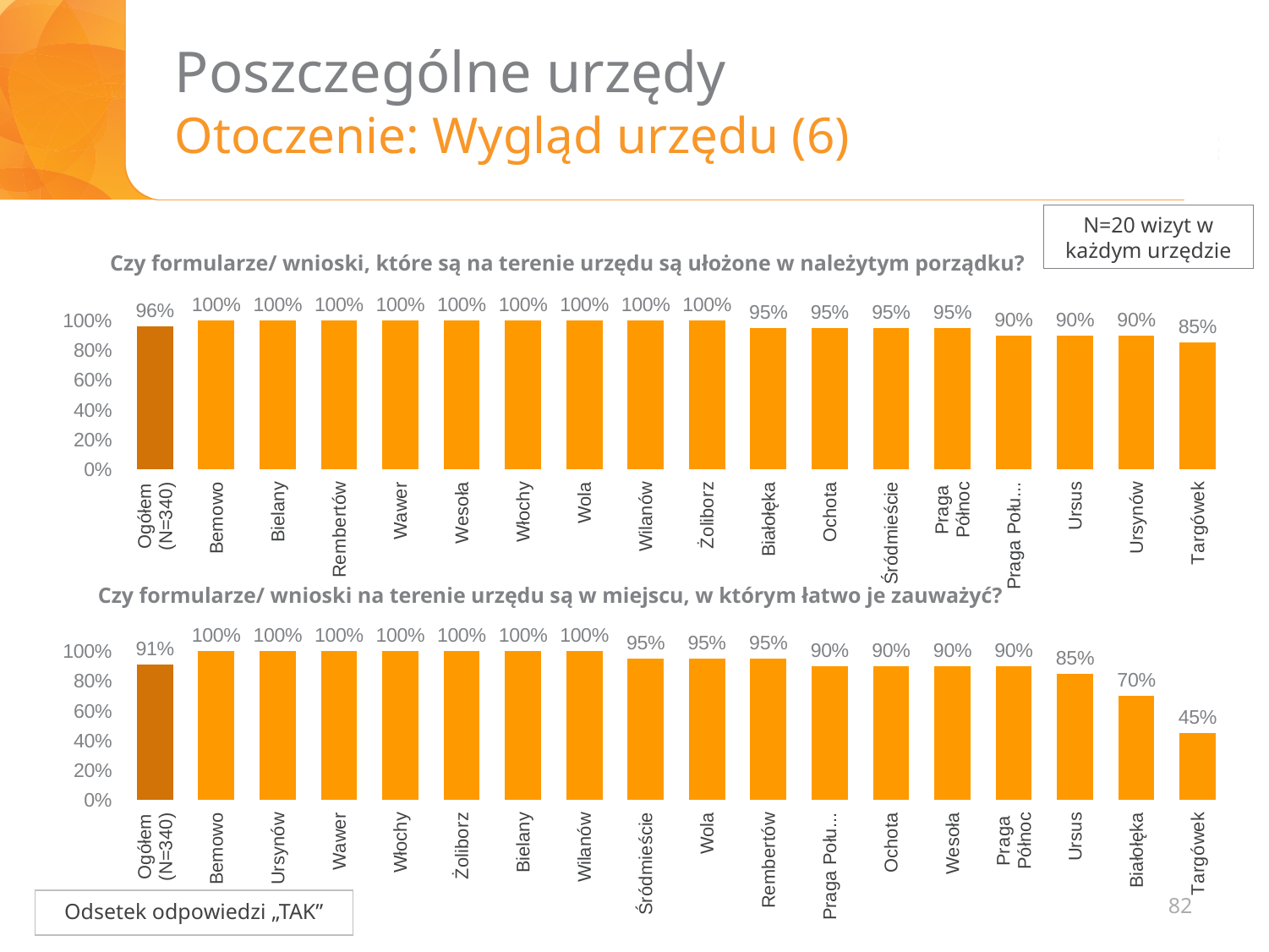
In the bottom chart, what is the difference between the values for Ursus and Targówek? 40% In the bottom chart, which is larger: the value for Śródmieście or the value for Ochota? Śródmieście In the top chart, what is the value for Targówek? 85% What type of chart is the bottom chart? Bar chart In the top chart, how many bars are plotted? 18 In the top chart, what is the difference between the values for Białołęka and Ursus? 5% In the bottom chart ("Czy formularze/ wnioski na terenie urzędu są w miejscu, w którym łatwo je zauważyć?"), what is the value for Ogółem (N=340)? 91% In the bottom chart, do the values generally rise or fall from left to right after the Ogółem bar? Fall In the bottom chart, which category has the lowest value? Targówek In the bottom chart, what is the value for Białołęka? 70% In the top chart, which category has the lowest value? Targówek In the top chart ("Czy formularze/ wnioski, które są na terenie urzędu są ułożone w należytym porządku?"), what is the value for Ogółem (N=340)? 96%